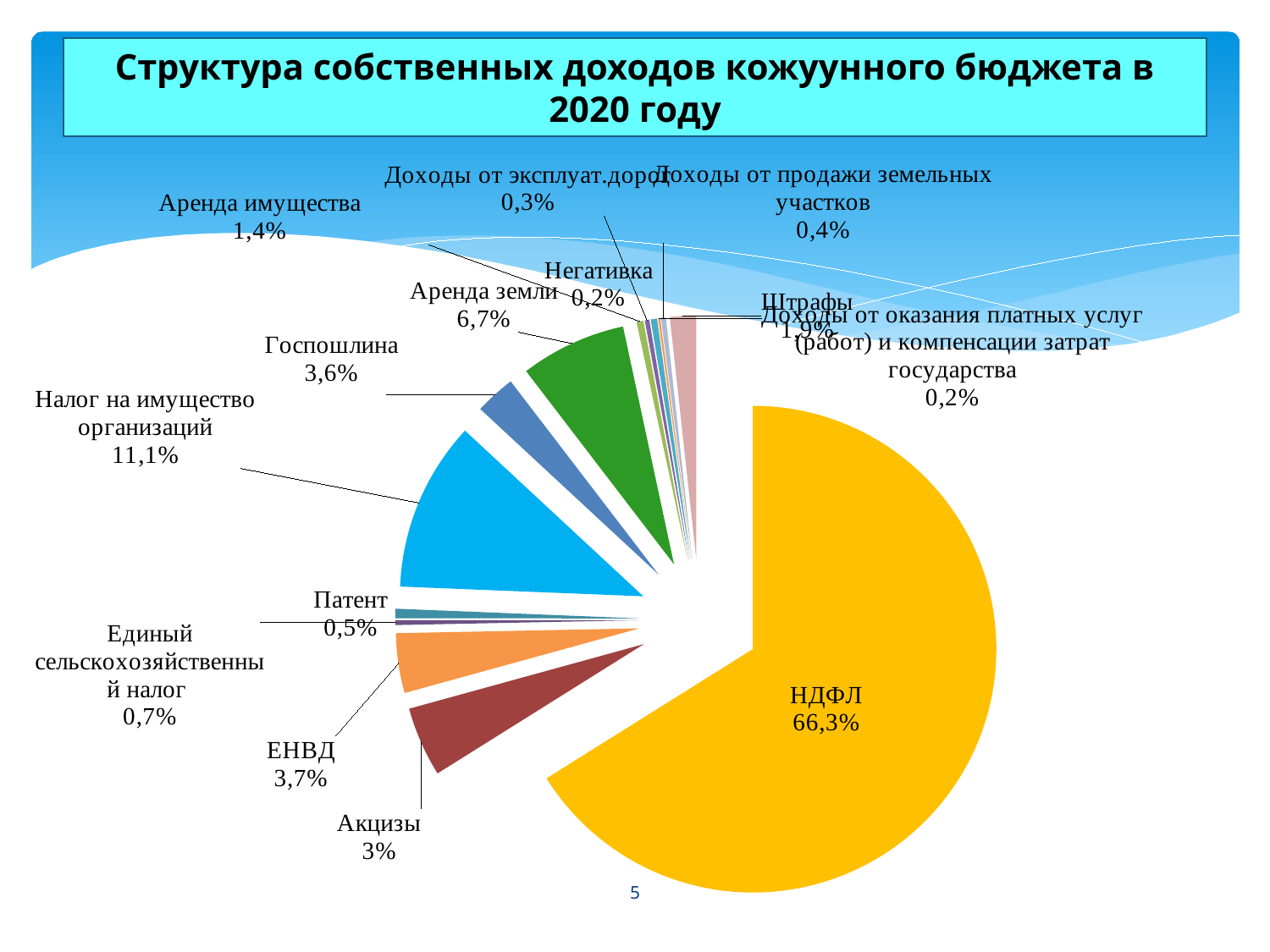
What is the value shown for Патент? 0,5% Which is larger, ЕНВД or Госпошлина? ЕНВД What is the value shown for Налог на имущество организаций? 11,1% What is the difference between the shares of НДФЛ and Налог на имущество организаций? 55,2% What is the difference between the shares of Аренда земли and Аренда имущества? 5,3% How many slices does the pie chart have? 14 Which category has the largest slice of the pie? НДФЛ What kind of chart is shown on the slide? pie chart What share of the pie does НДФЛ account for? 66,3% What is the value shown for Аренда земли? 6,7% What is the title of the chart on the slide? Структура собственных доходов кожуунного бюджета в 2020 году What is the value shown for Акцизы? 3%